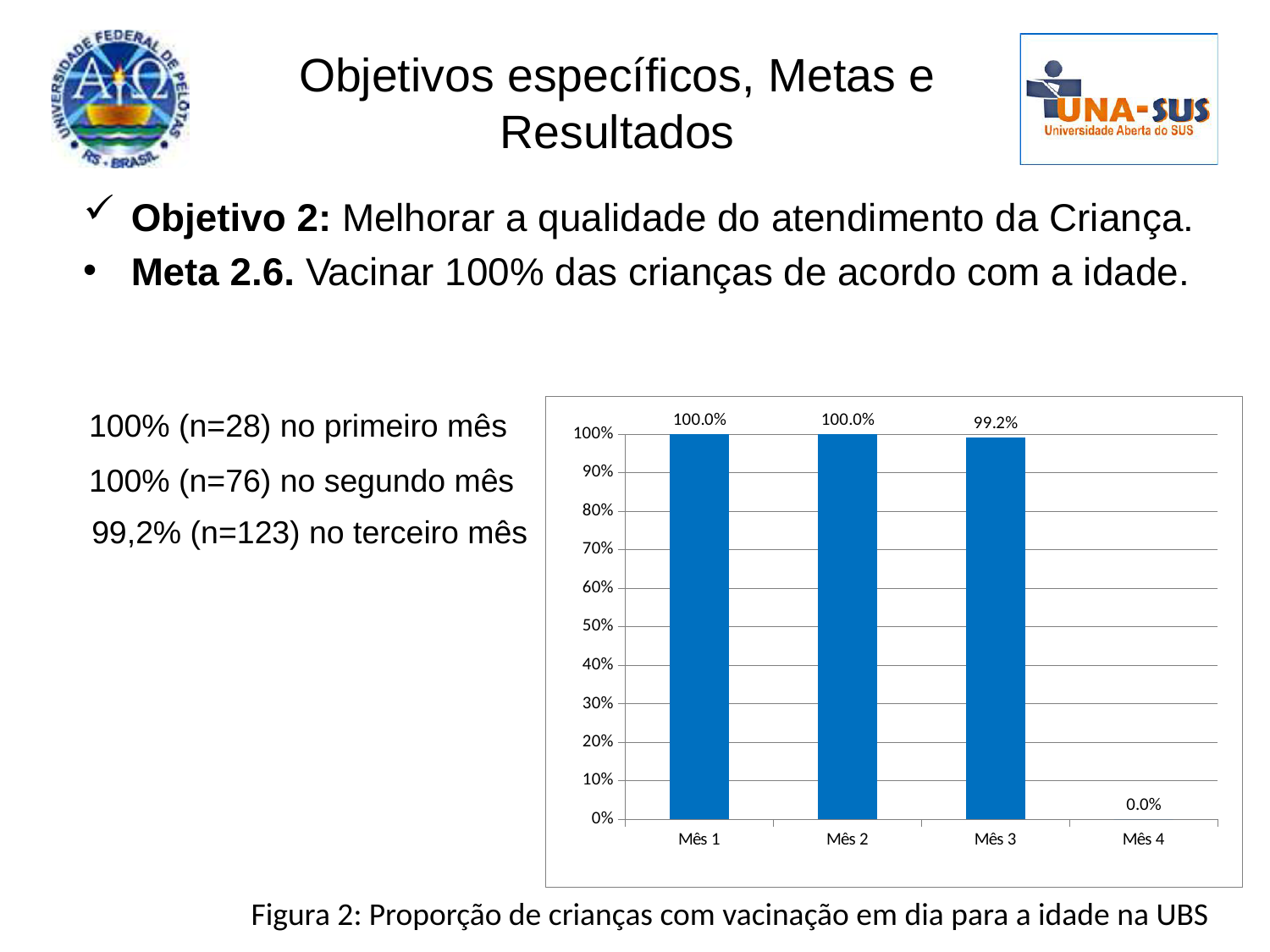
What is the value for Mês 4? 0.0% What is the value for Mês 3? 99.2% What is the value for Mês 1? 100.0% How many categories are shown on the x axis? 4 What is the difference between the values for Mês 2 and Mês 3? 0.8% Which category has the lowest value? Mês 4 What is the highest tick value shown on the y axis? 100% What is the caption of the figure below the chart? Figura 2: Proporção de crianças com vacinação em dia para a idade na UBS What kind of chart is shown on the slide? bar chart Is the value for Mês 3 greater or less than 90%? greater Which is larger, the value for Mês 3 or the value for Mês 4? Mês 3 Do the values rise or fall from Mês 2 to Mês 4? fall